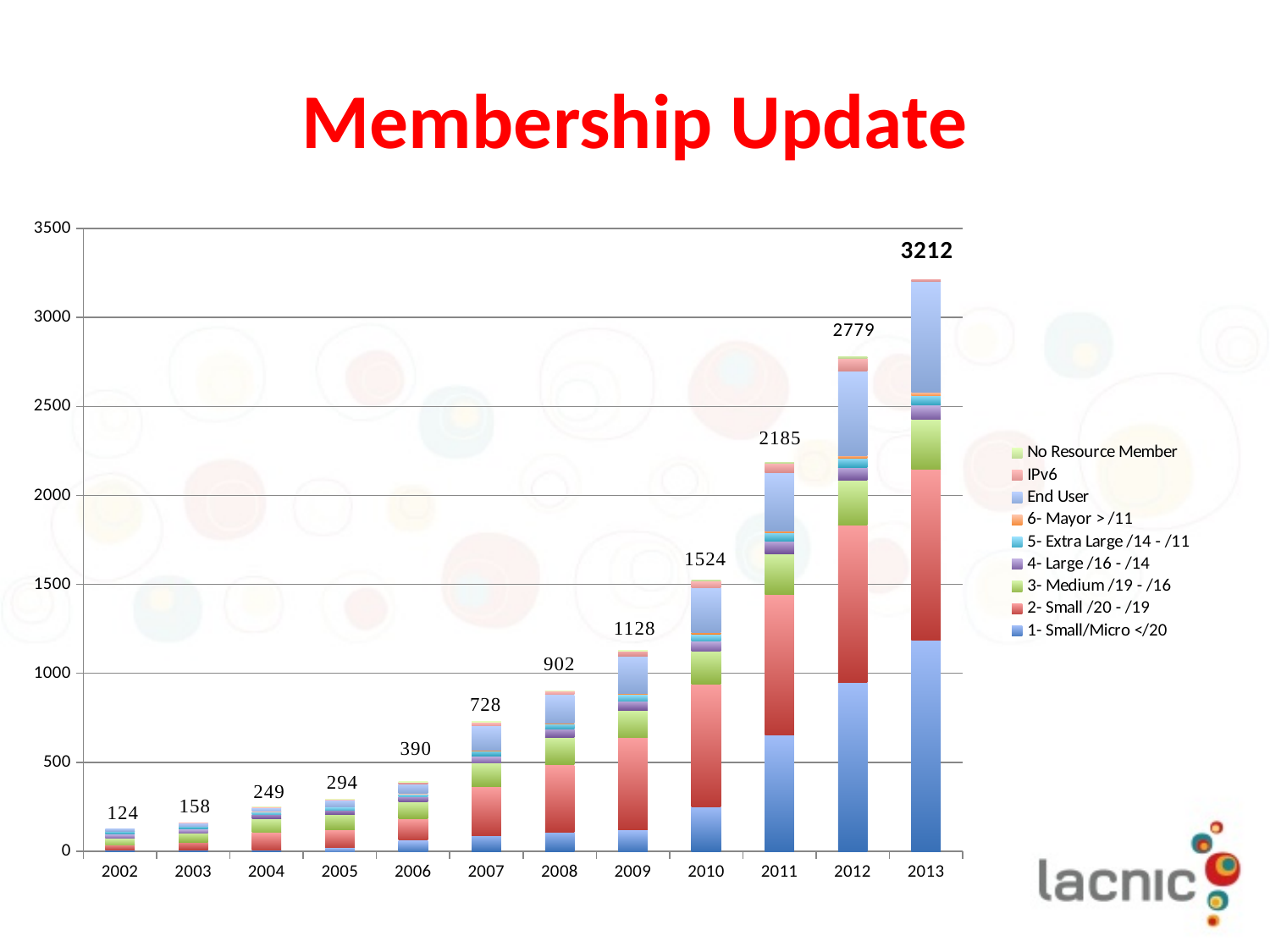
Which year has the highest total membership? 2013 Do the total membership values rise or fall from 2002 to 2013? Rise How many series does the legend list? 9 What kind of chart is shown on the slide? Stacked bar chart Which year has a larger total membership, 2007 or 2009? 2009 What is the difference between the total membership in 2011 and in 2010? 661 What is the total membership shown for 2013? 3212 Which year has the lowest total membership? 2002 What is the difference between the total membership in 2013 and in 2012? 433 What is the total membership shown for 2008? 902 What is the total membership shown for 2002? 124 How many years are shown on the x axis? 12